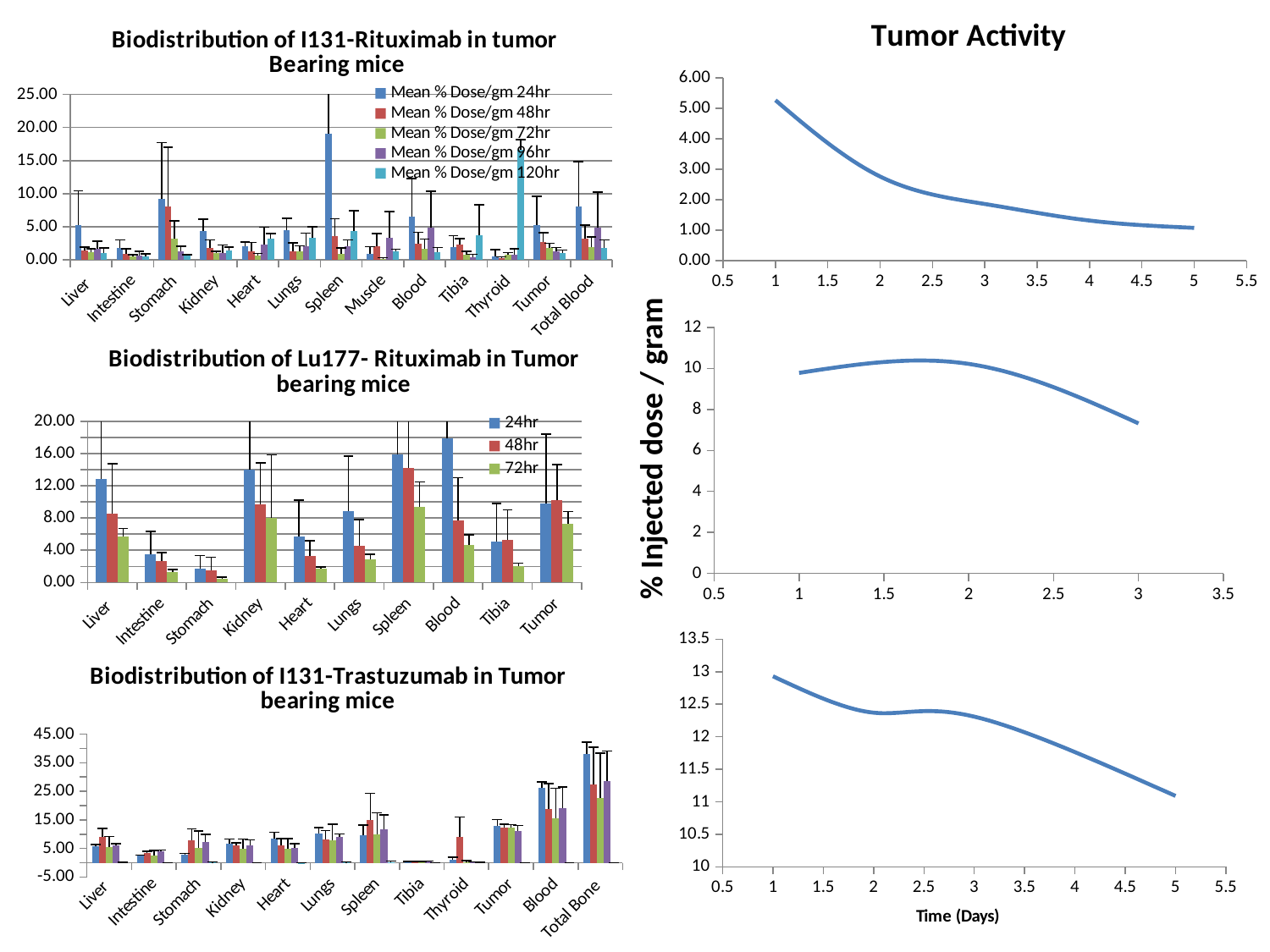
In the "Biodistribution of Lu177- Rituximab in Tumor bearing mice" chart, which organ has the highest 24hr value? Blood How many organ categories are shown on the x axis of the "Biodistribution of Lu177- Rituximab in Tumor bearing mice" chart? 10 In the "Biodistribution of Lu177- Rituximab in Tumor bearing mice" chart, is the 24hr value for Liver greater or less than 8.00? greater How many series does the legend of the "Biodistribution of Lu177- Rituximab in Tumor bearing mice" chart list? 3 How many categories are shown on the x axis of the "Biodistribution of I131-Trastuzumab in Tumor bearing mice" chart? 12 In the "Biodistribution of I131-Trastuzumab in Tumor bearing mice" chart, is the first (blue) series value for Total Bone greater or less than 25.00? greater In the "Biodistribution of Lu177- Rituximab in Tumor bearing mice" chart, which is larger, the 24hr value for Kidney or the 24hr value for Heart? Kidney What kind of chart is "Biodistribution of I131-Rituximab in tumor Bearing mice"? Bar chart In the "Biodistribution of I131-Rituximab in tumor Bearing mice" chart, which organ has the highest Mean % Dose/gm 24hr value? Spleen How many series does the legend of the "Biodistribution of I131-Rituximab in tumor Bearing mice" chart list? 5 In the top-right "Tumor Activity" chart, do the values rise or fall as time increases along the x axis? Fall What is the x-axis label of the bottom-right line chart? Time (Days)